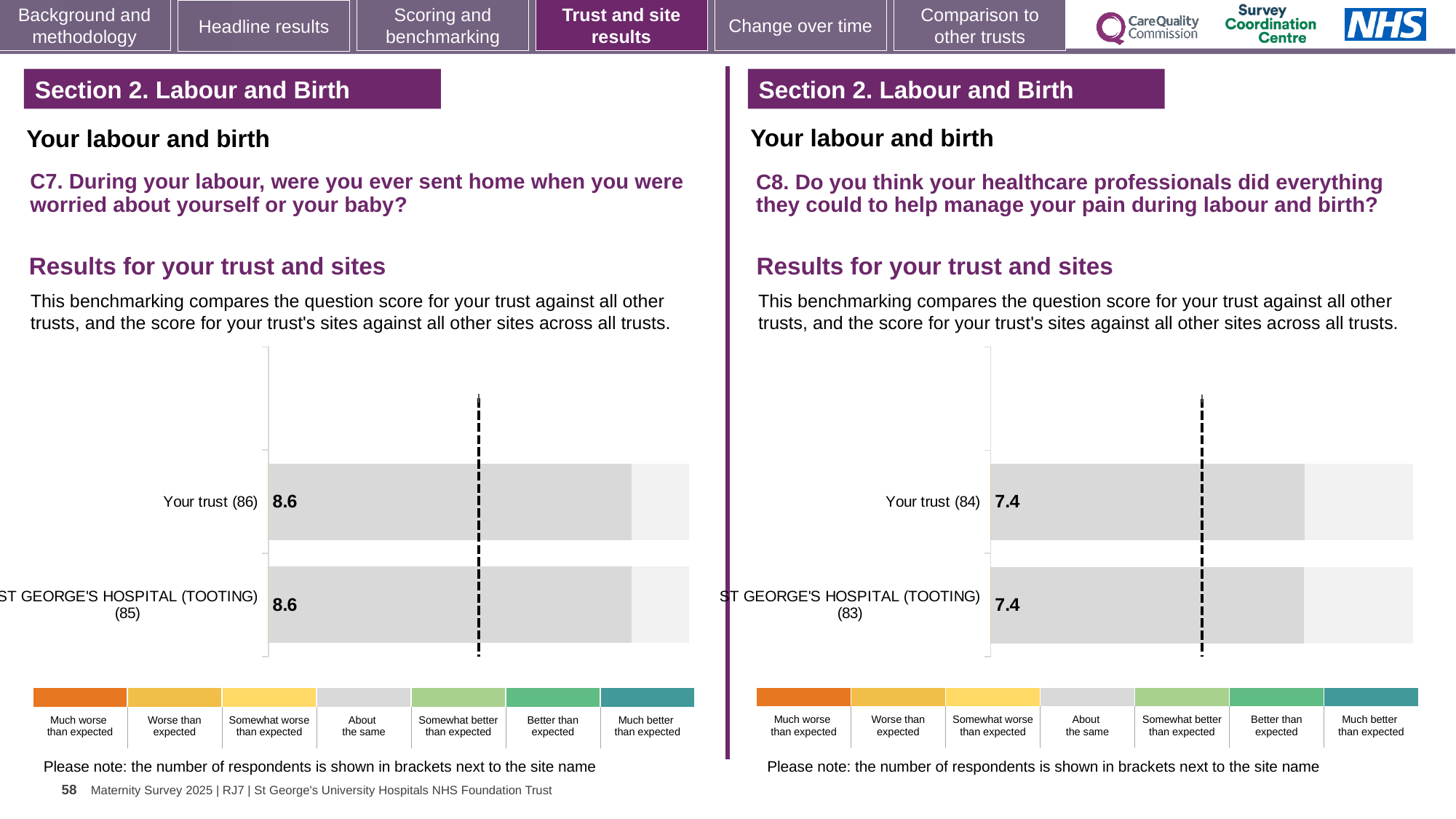
On the left chart (C7), what is the score for ST GEORGE'S HOSPITAL (TOOTING)? 8.6 What type of chart is used on the left (C7)? Bar chart On the right chart (C8), what is the score for Your trust? 7.4 On the right chart (C8), what is the difference between the Your trust score and the ST GEORGE'S HOSPITAL (TOOTING) score? 0 On the right chart (C8), how many respondents are shown in brackets next to ST GEORGE'S HOSPITAL (TOOTING)? 83 How many bars are plotted on the right chart (C8)? 2 On the right chart (C8), what is the score for ST GEORGE'S HOSPITAL (TOOTING)? 7.4 On the left chart (C7), how many respondents are shown in brackets next to Your trust? 86 On the left chart (C7), what is the difference between the Your trust score and the ST GEORGE'S HOSPITAL (TOOTING) score? 0 How many bars are plotted on the left chart (C7)? 2 On the left chart (C7), what is the score for Your trust? 8.6 Is the Your trust score on the left chart (C7) larger or smaller than the Your trust score on the right chart (C8)? Larger